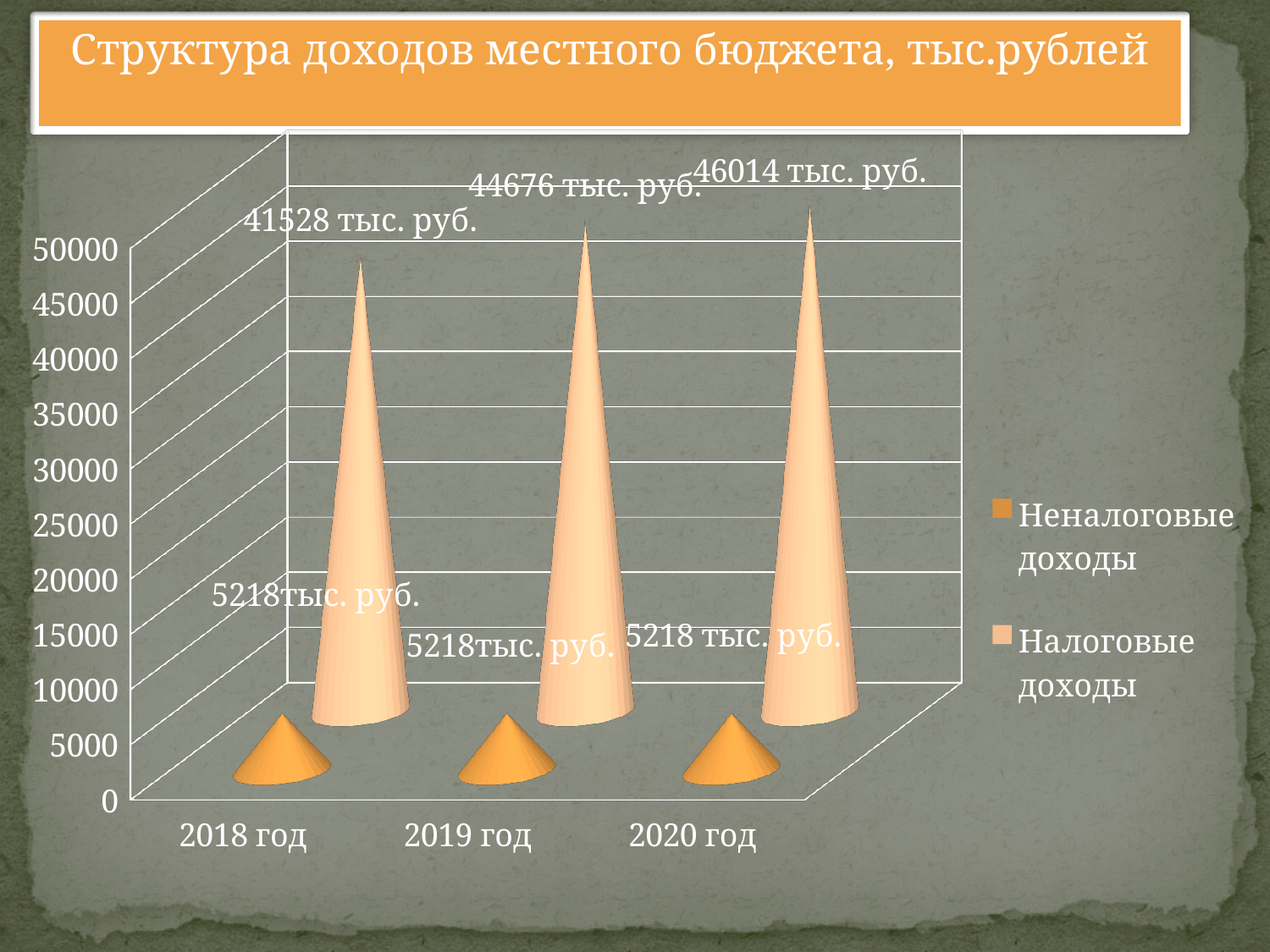
What is the difference between Налоговые доходы in 2020 год and 2018 год? 4486 тыс. руб. In which year is Налоговые доходы lowest? 2018 год What is the value for Неналоговые доходы in 2020 год? 5218 тыс. руб. What is the value for Налоговые доходы in 2019 год? 44676 тыс. руб. Do the values for Налоговые доходы rise or fall from 2018 год to 2020 год? rise How many years are shown on the x axis? 3 In which year is Налоговые доходы highest? 2020 год What is the difference between Налоговые доходы in 2019 год and 2018 год? 3148 тыс. руб. What is the value for Налоговые доходы in 2020 год? 46014 тыс. руб. Which is larger in 2019 год: Налоговые доходы or Неналоговые доходы? Налоговые доходы What is the value for Налоговые доходы in 2018 год? 41528 тыс. руб. How many series does the legend list? 2